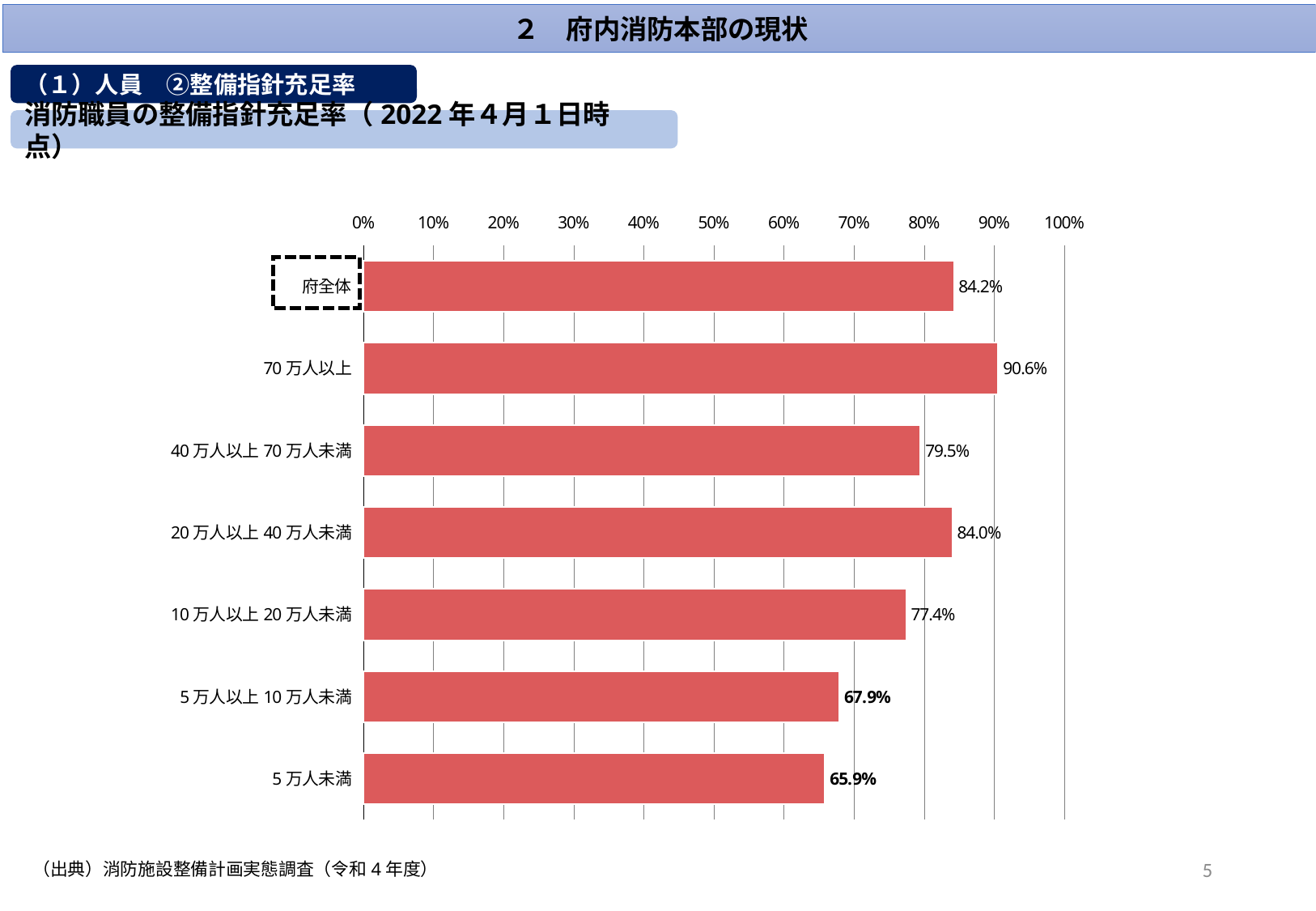
What is the value for 10万人以上20万人未満? 77.4% What is the value for 5万人未満? 65.9% How many categories are shown in the chart? 7 What is the value for 府全体? 84.2% Which is larger, the value for 40万人以上70万人未満 or the value for 5万人以上10万人未満? 40万人以上70万人未満 What is the title of the chart? 消防職員の整備指針充足率（2022年4月1日時点） Is the value for 20万人以上40万人未満 greater or less than 80%? greater Which category has the lowest value? 5万人未満 Which category has the highest value? 70万人以上 What is the value for 70万人以上? 90.6% What is the difference between the values for 70万人以上 and 5万人未満? 24.7% What kind of chart is shown on the slide? bar chart